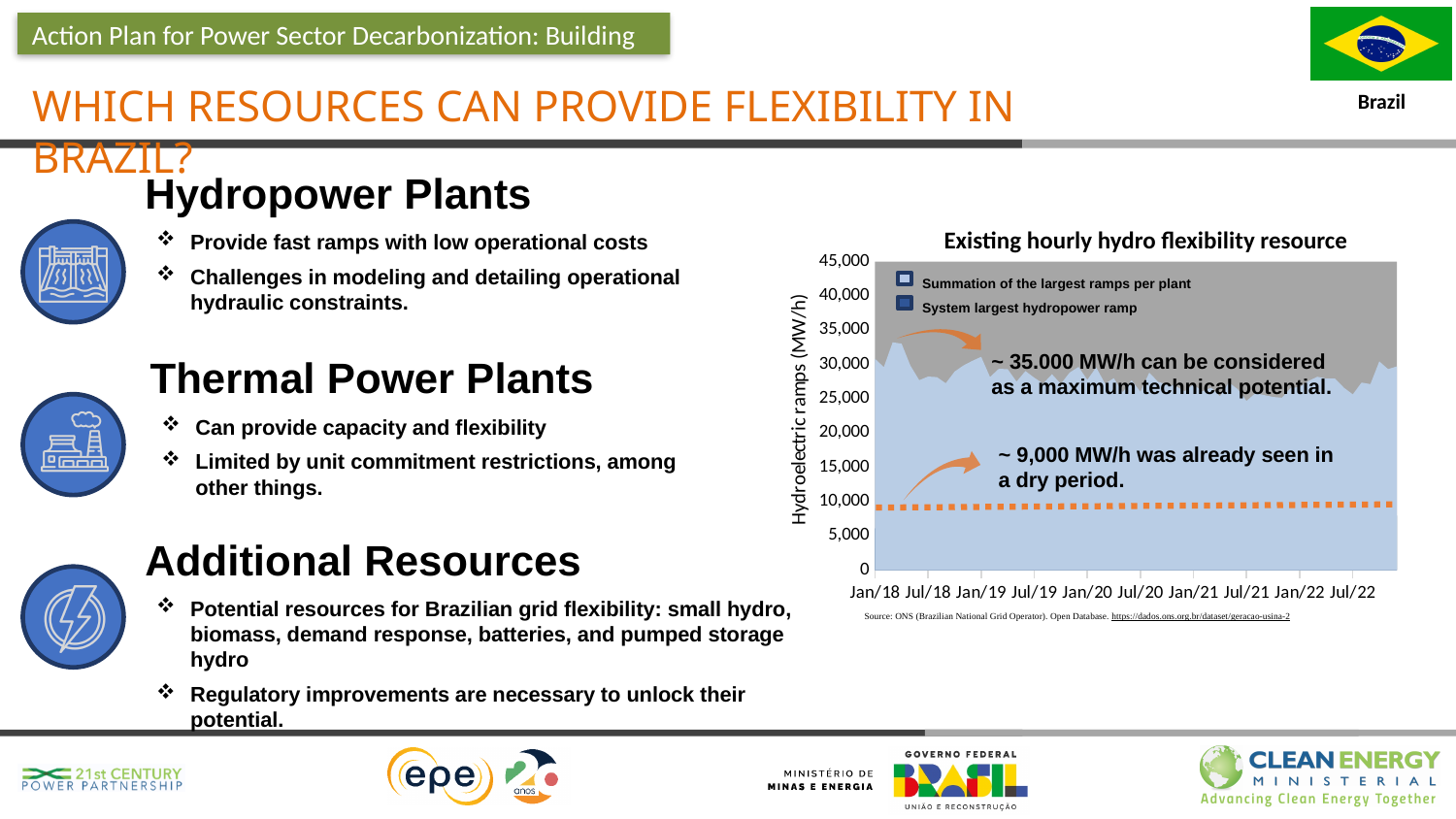
What kind of chart is shown on the slide? Area chart According to the chart annotation, what value was already seen in a dry period? ~ 9,000 MW/h What is the highest value shown on the chart's vertical axis? 45,000 According to the chart annotation, what value can be considered as a maximum technical potential? ~ 35.000 MW/h What is the first date label on the chart's horizontal axis? Jan/18 What is the title of the chart on the slide? Existing hourly hydro flexibility resource Is the dashed orange line on the chart greater or less than 15,000 MW/h? less Is the 'Summation of the largest ramps per plant' series greater or less than 20,000 MW/h across the period shown? greater Which series is larger throughout the chart, 'Summation of the largest ramps per plant' or 'System largest hydropower ramp'? Summation of the largest ramps per plant What is the label of the vertical axis of the chart? Hydroelectric ramps (MW/h) How many series does the chart's legend list? 2 What is the last date label on the chart's horizontal axis? Jul/22